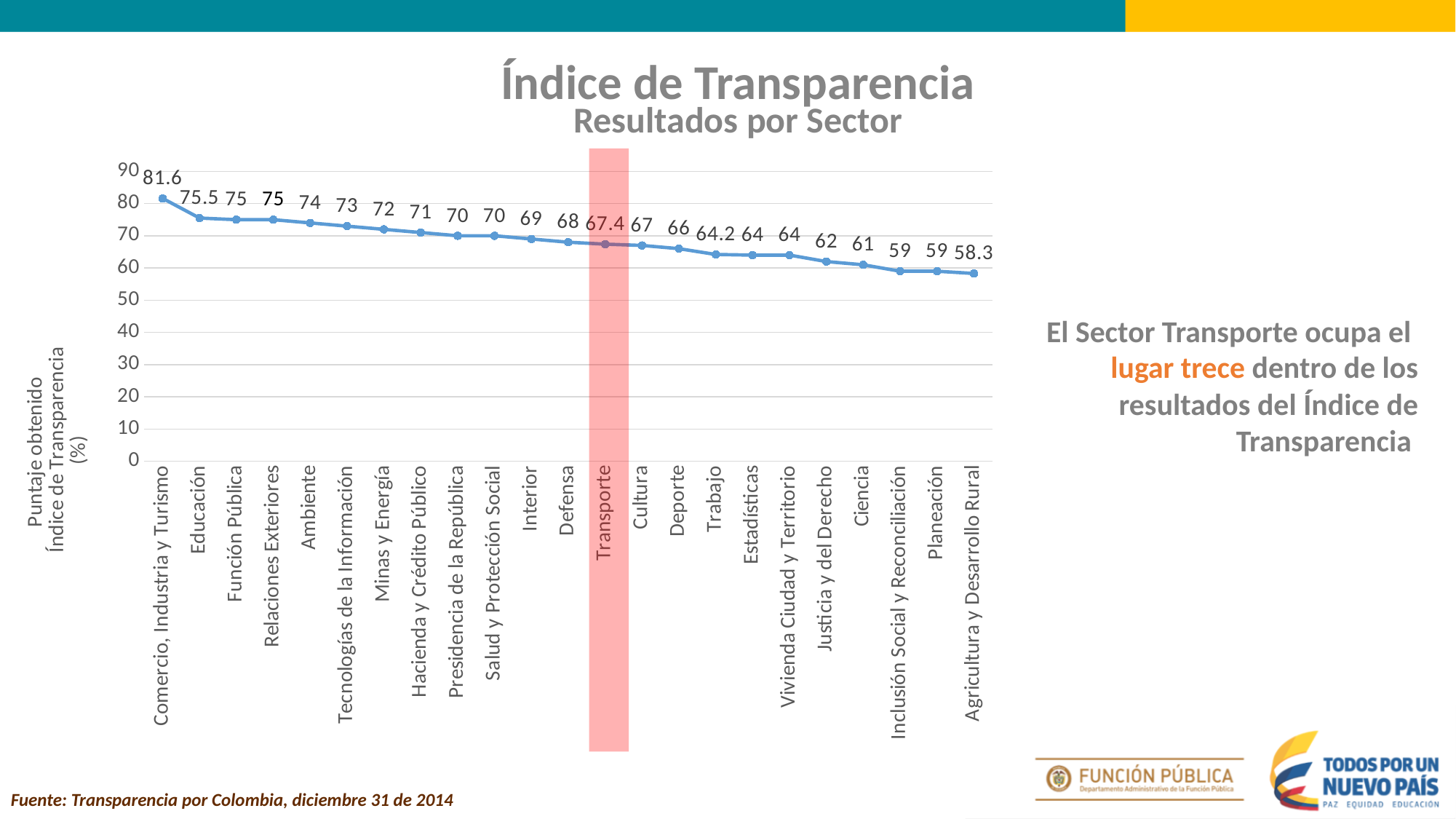
What is the value for Comercio, Industria y Turismo? 81.6 What is the difference between the values for Comercio, Industria y Turismo and Agricultura y Desarrollo Rural? 23.3 What is the difference between the values for Educación and Transporte? 8.1 Which sector has the lowest value? Agricultura y Desarrollo Rural What is the subtitle of the chart? Resultados por Sector What is the value for Trabajo? 64.2 Which sector has the highest value? Comercio, Industria y Turismo What is the value for Transporte? 67.4 Do the values rise or fall from left to right along the x axis? fall How many sectors are plotted on the chart? 23 What type of chart is shown on the slide? line chart Which has a higher value, Ambiente or Deporte? Ambiente